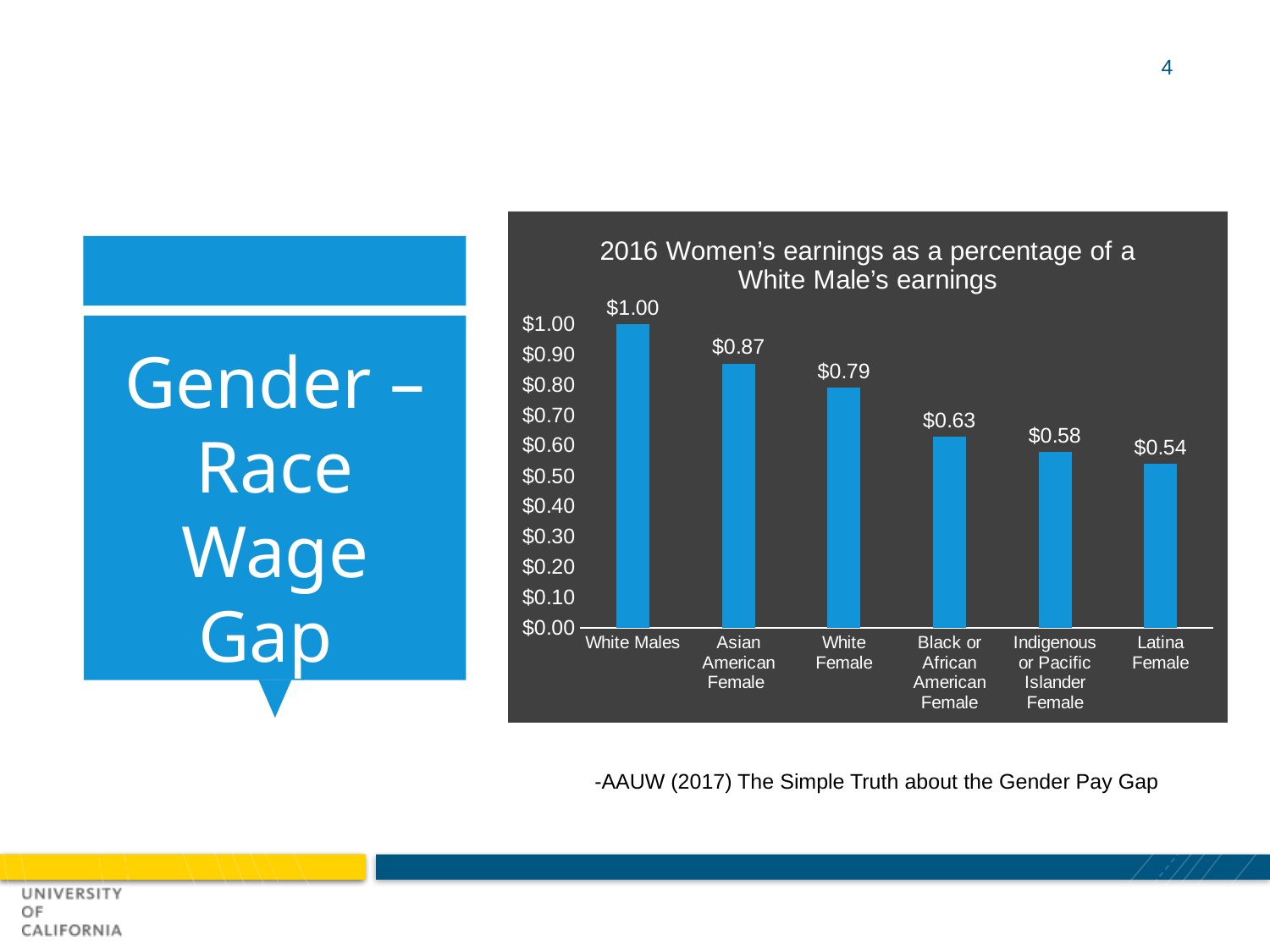
What is the title of the chart? 2016 Women's earnings as a percentage of a White Male's earnings Which is larger, the value for Indigenous or Pacific Islander Female or the value for Black or African American Female? Black or African American Female What is the value for Asian American Female? $0.87 Which category has the highest value? White Males What is the value for Black or African American Female? $0.63 Is the value for White Female greater or less than $0.70? greater What is the value for Latina Female? $0.54 What is the difference between the values for White Female and Latina Female? $0.25 What is the difference between the values for White Males and Asian American Female? $0.13 What kind of chart is shown on the slide? bar chart How many categories are shown on the x axis? 6 Which category has the lowest value? Latina Female